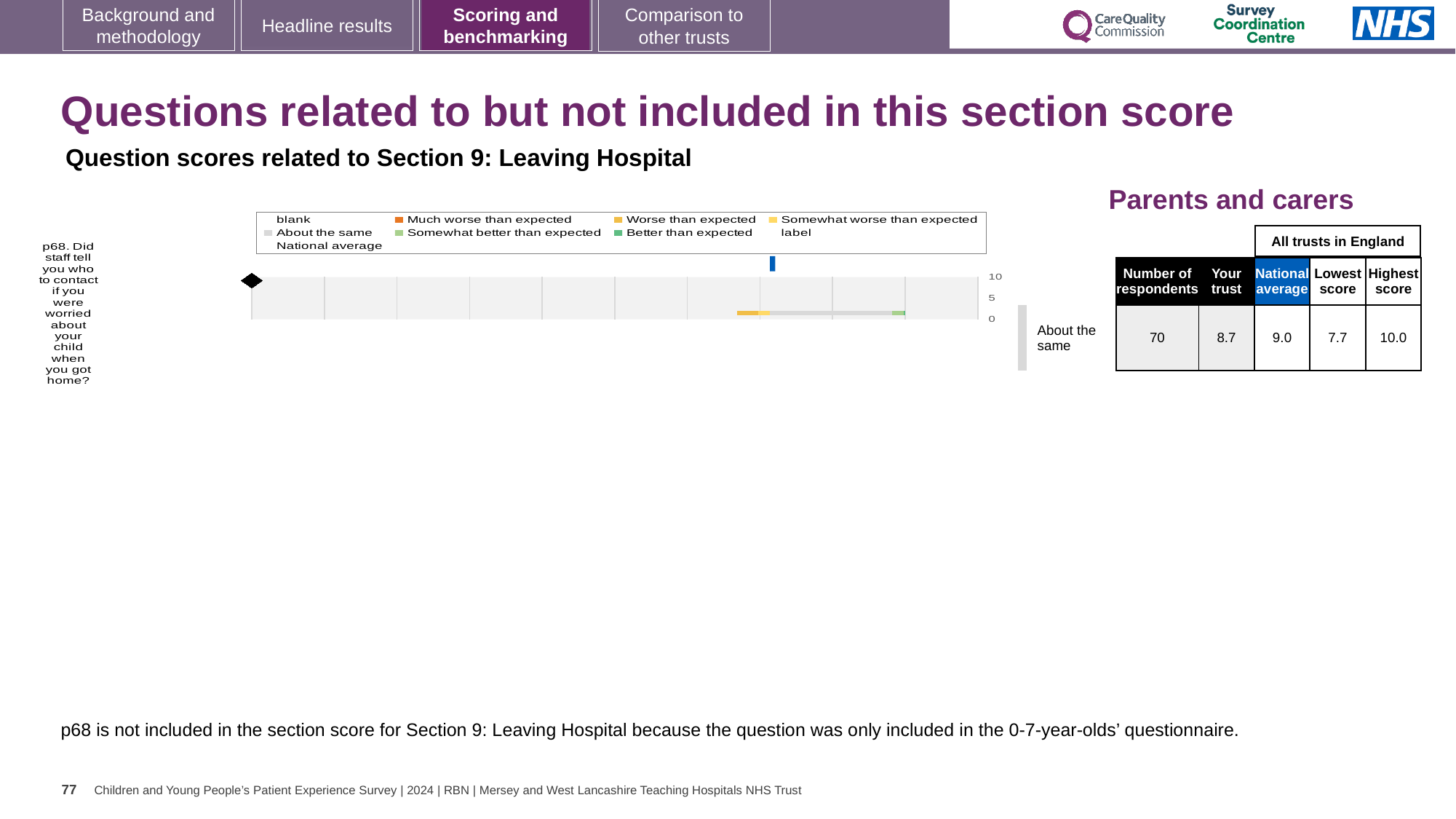
What is the highest score across all trusts in England for p68? 10.0 Which question number is plotted in the chart? p68 Which is larger for p68, the trust's score or the national average? national average What kind of chart is shown for question p68? bar chart What is the lowest score across all trusts in England for p68? 7.7 How many respondents answered p68? 70 What is the national average score for p68? 9.0 Is the trust's score for p68 greater or less than 5 on the chart axis? greater What benchmark category is the trust's p68 score assigned to? About the same What is the 'Your trust' score for p68 shown in the table? 8.7 How many survey questions are plotted in the chart? 1 What is the difference between the national average and the trust's score for p68? 0.3